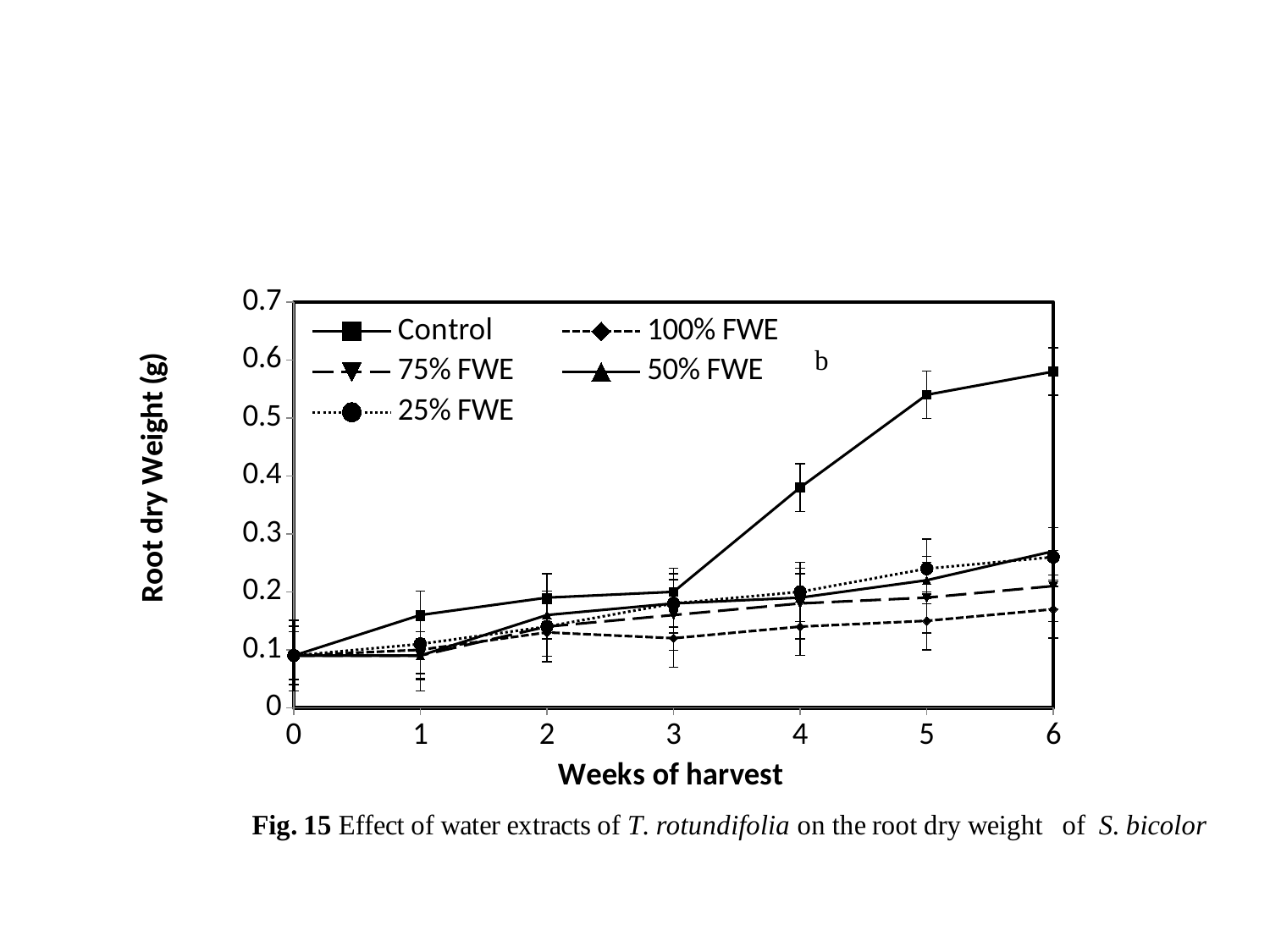
How many weeks of harvest are plotted along the x axis? 7 At week 5, which is larger: the Control value or the 100% FWE value? Control What is the title of the x axis? Weeks of harvest Is the Control value at week 4 greater or less than 0.3? greater What kind of chart is shown on the slide? line chart How many series does the legend list? 5 Is the 100% FWE value at week 6 greater or less than 0.2? less What is the title of the y axis? Root dry Weight (g) Does the Control series rise or fall from week 0 to week 6? rise Is the Control value at week 6 greater or less than 0.5? greater Which series has the highest root dry weight at week 6? Control Which series has the lowest root dry weight at week 6? 100% FWE